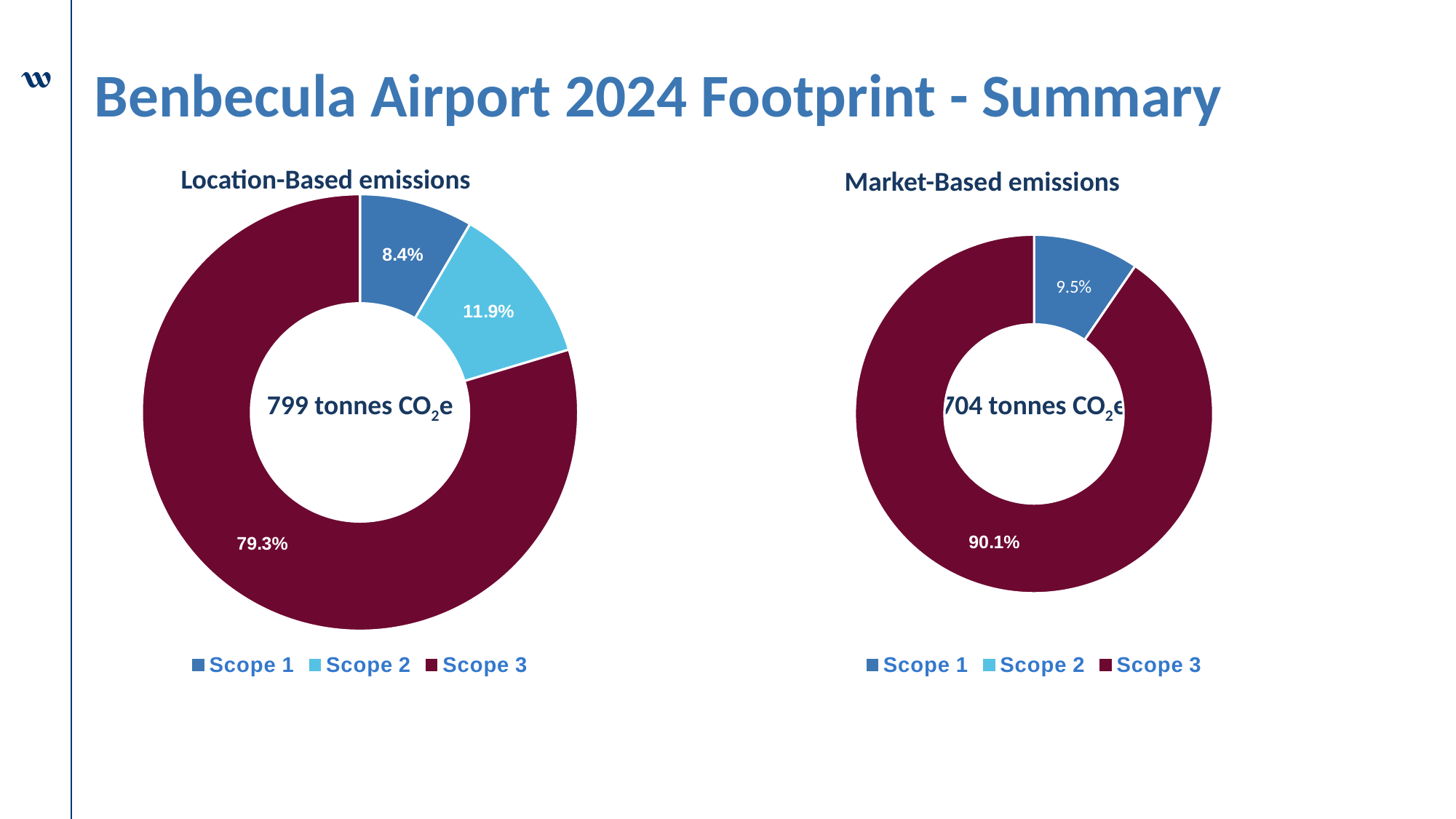
In the Location-Based emissions chart, what share of emissions is Scope 1? 8.4% In the Location-Based emissions chart, what share of emissions is Scope 2? 11.9% In the Market-Based emissions chart, what share of emissions is Scope 1? 9.5% In the Location-Based emissions chart, which is larger, the Scope 2 share or the Scope 1 share? Scope 2 What total is shown in the centre of the Market-Based emissions chart? 704 tonnes CO2e In the Location-Based emissions chart, what is the difference in percentage points between the Scope 2 and Scope 1 shares? 3.5 In the Location-Based emissions chart, which scope has the smallest share? Scope 1 What total is shown in the centre of the Location-Based emissions chart? 799 tonnes CO2e What kind of chart is the Market-Based emissions chart? Doughnut chart In the Location-Based emissions chart, which scope has the largest share? Scope 3